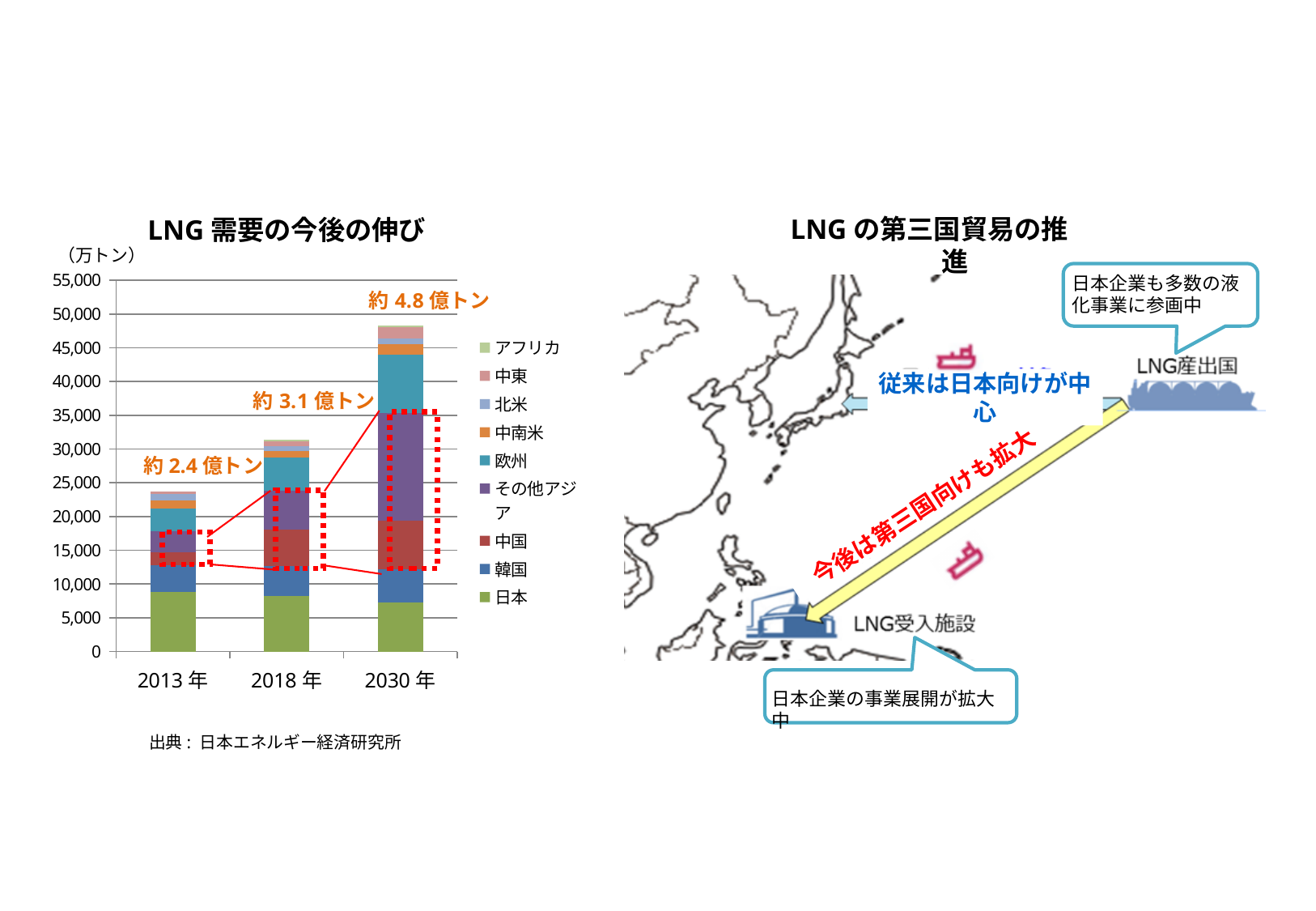
How many series does the legend of the 'LNG 需要の今後の伸び' chart list? 9 What unit is shown at the top of the y axis of the 'LNG 需要の今後の伸び' chart? 万トン In the 'LNG 需要の今後の伸び' chart, which year has the tallest stacked bar? 2030 年 In the 'LNG 需要の今後の伸び' chart, is the 日本 segment for 2030 年 greater or less than 10,000? less In the 'LNG 需要の今後の伸び' chart, which year has the shortest stacked bar? 2013 年 How many years (categories) are shown on the x axis of the 'LNG 需要の今後の伸び' chart? 3 In the 'LNG 需要の今後の伸び' chart, is the total for 2013 年 greater or less than 25,000? less In the 'LNG 需要の今後の伸び' chart, is the total for 2030 年 greater or less than 45,000? greater What annotation is printed above the 2030 年 bar in the 'LNG 需要の今後の伸び' chart? 約 4.8 億トン What kind of chart is 'LNG 需要の今後の伸び'? stacked bar chart In the 'LNG 需要の今後の伸び' chart, do the total bar heights rise or fall from 2013 年 to 2030 年? rise